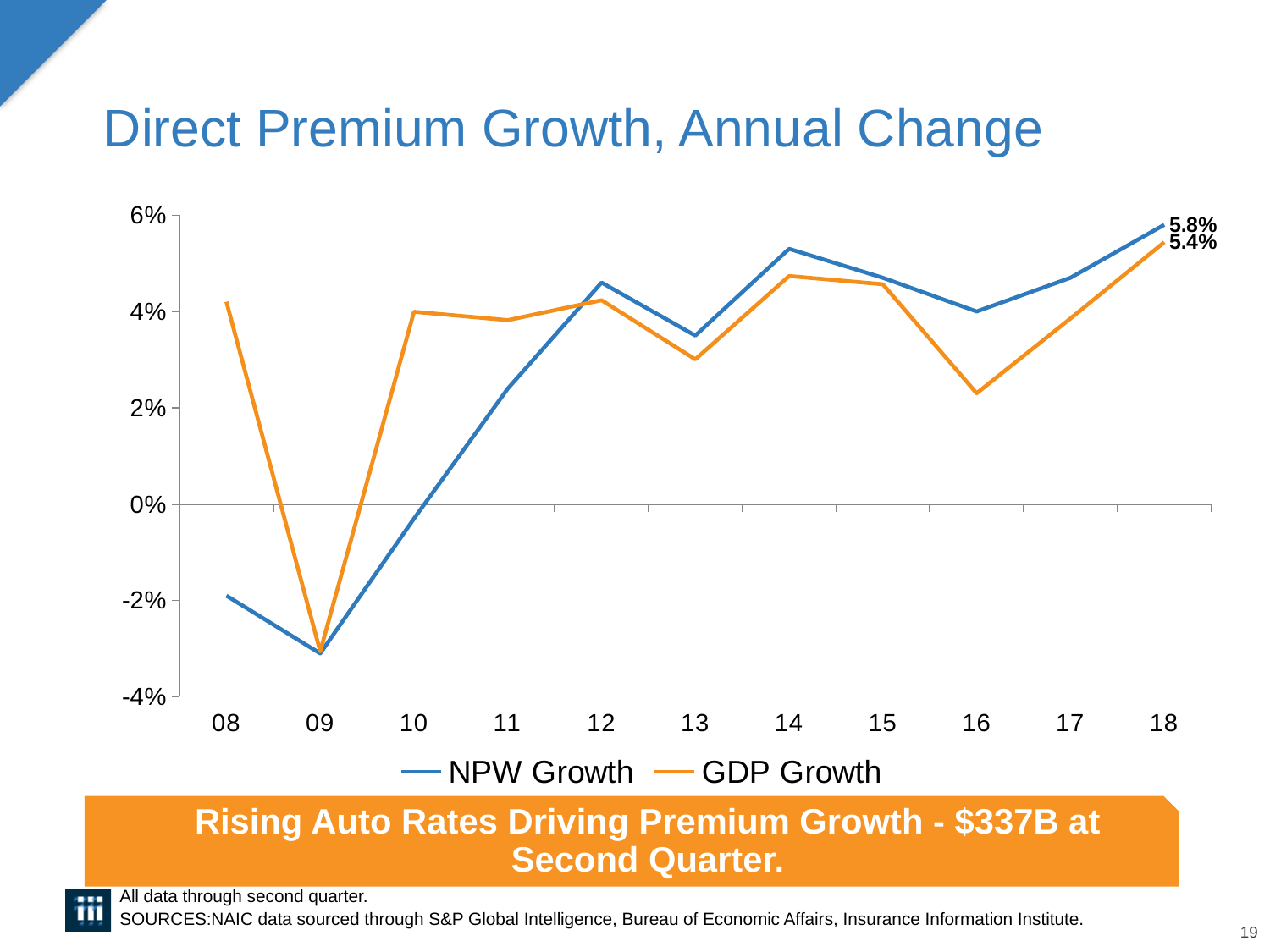
Is the NPW Growth value for 09 greater or less than -2%? less Does NPW Growth rise or fall from 09 to 12? Rise Is the NPW Growth value for 14 greater or less than 4%? greater How many years are shown on the x axis? 11 What is the NPW Growth value for 18? 5.8% Is the GDP Growth value for 16 greater or less than 4%? less In which year is NPW Growth at its lowest? 09 How many series does the legend list? 2 What is the GDP Growth value for 18? 5.4% What is the difference between NPW Growth and GDP Growth in 18? 0.4% What kind of chart is shown on the slide? Line chart In 18, which series is higher, NPW Growth or GDP Growth? NPW Growth